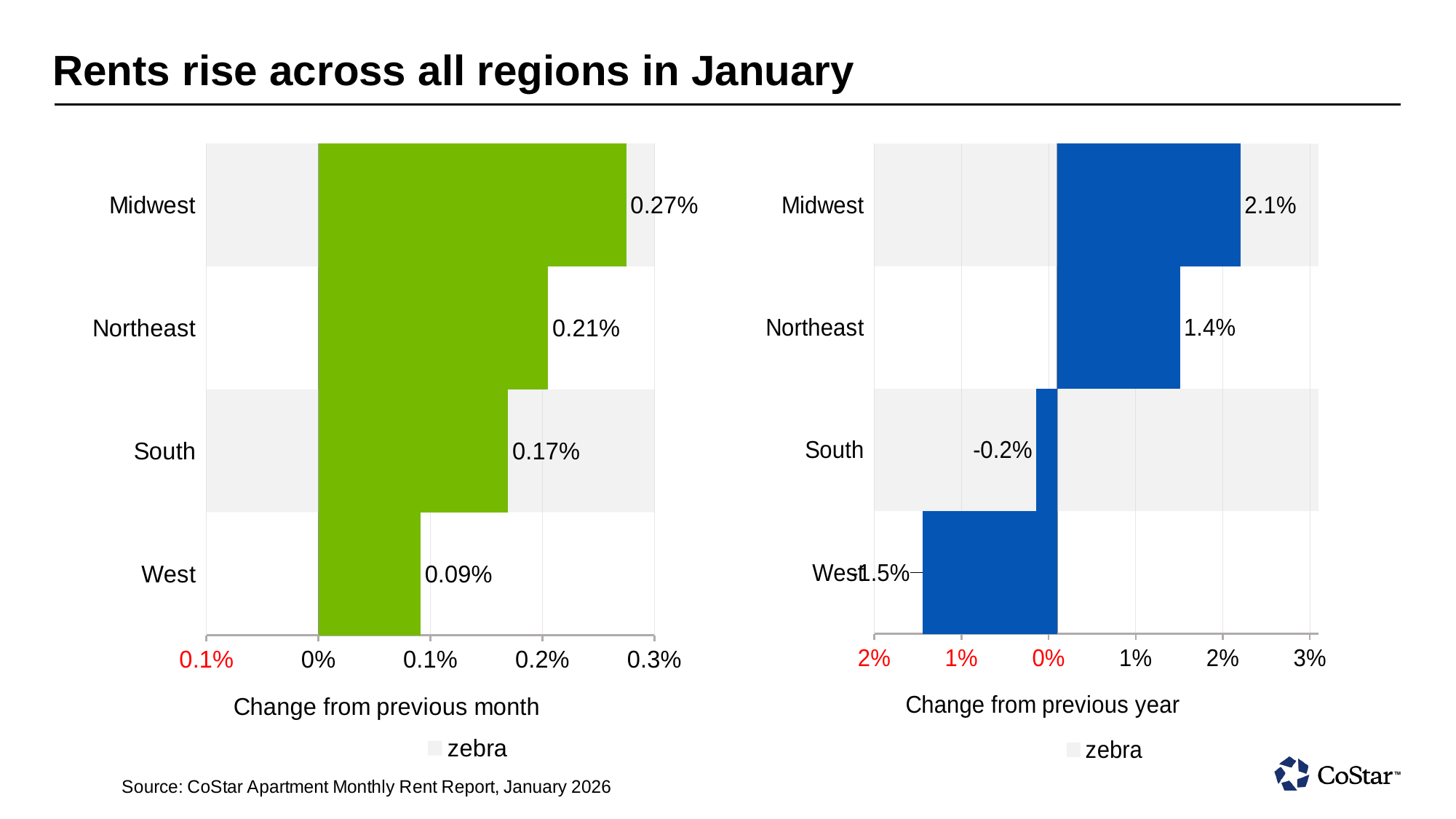
In the 'Change from previous year' chart, which region has the lowest value? West In the 'Change from previous month' chart, what is the difference between the Midwest and West values? 0.18% In the 'Change from previous year' chart, is the value for the West greater or less than 0%? less How many regions are shown in the 'Change from previous month' chart? 4 In the 'Change from previous year' chart, what is the value for the Northeast? 1.4% In the 'Change from previous month' chart, which region has the highest value? Midwest What kind of chart is the 'Change from previous year' chart? bar chart In the 'Change from previous year' chart, what is the difference between the Midwest and Northeast values? 0.7% In the 'Change from previous month' chart, what is the value for the Midwest? 0.27% In the 'Change from previous month' chart, which is larger, the value for the Northeast or the South? Northeast In the 'Change from previous year' chart, what is the value for the South? -0.2% In the 'Change from previous month' chart, what is the value for the West? 0.09%